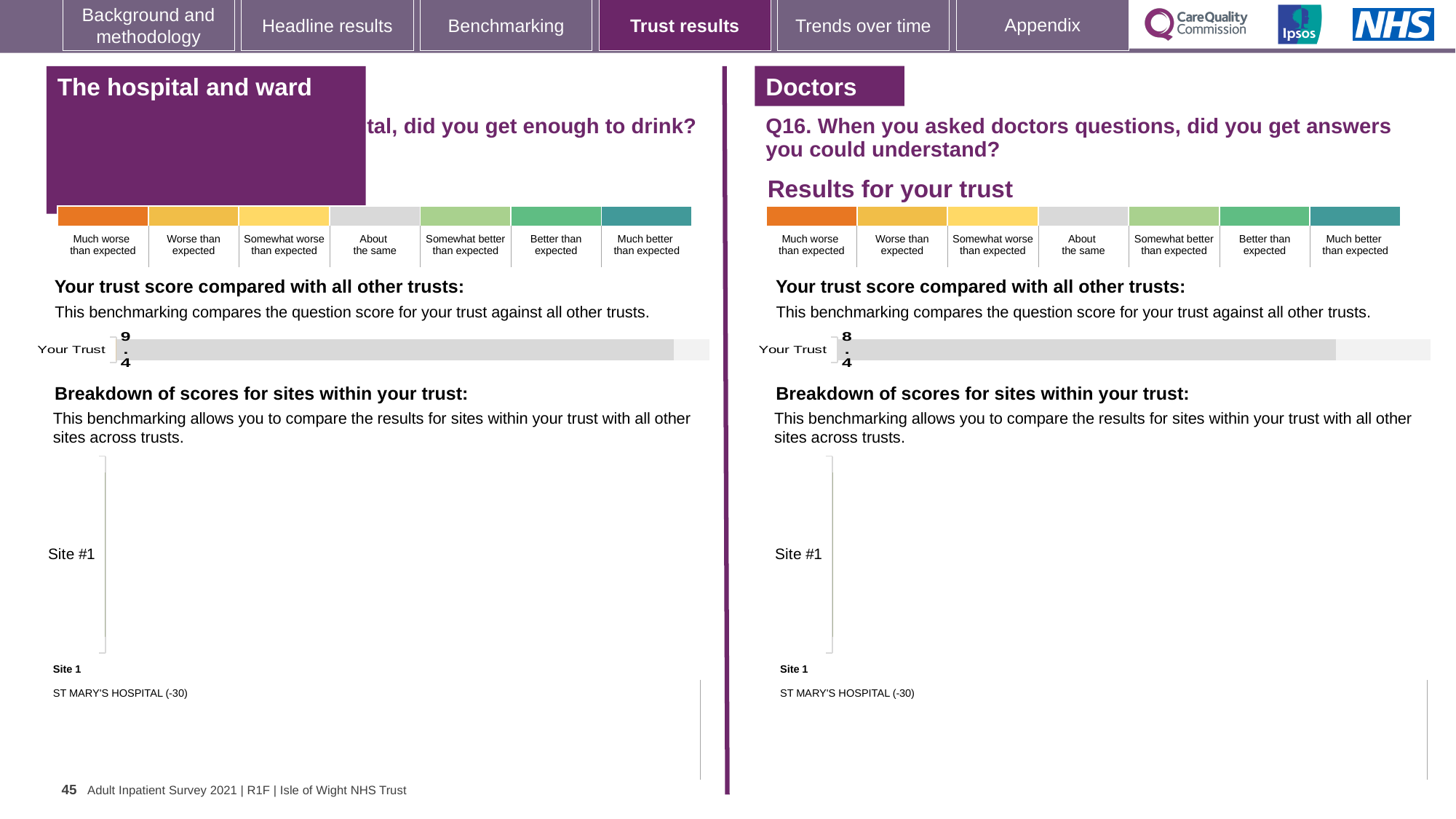
What kind of chart is used to show the Your Trust score on the right (Q16) panel? Bar chart Which is larger: the Your Trust score on the left chart or the Your Trust score on the right chart (Q16)? The left chart What is the difference between the Your Trust score on the left chart (9.4) and the Your Trust score on the right chart (8.4)? 1.0 On the right chart (Q16) under 'Your trust score compared with all other trusts', what is the value shown for Your Trust? 8.4 Is the Your Trust score on the right chart (Q16) greater or less than 9? less What is the category label shown on the 'Breakdown of scores for sites within your trust' chart on the right (Q16) panel? Site #1 What is the category label on the 'Your trust score compared with all other trusts' chart on the right (Q16) panel? Your Trust How many categories are plotted in the 'Your trust score compared with all other trusts' chart on the left panel? 1 Is the Your Trust score on the left chart greater or less than 9? greater On the left chart under 'Your trust score compared with all other trusts', what is the value shown for Your Trust? 9.4